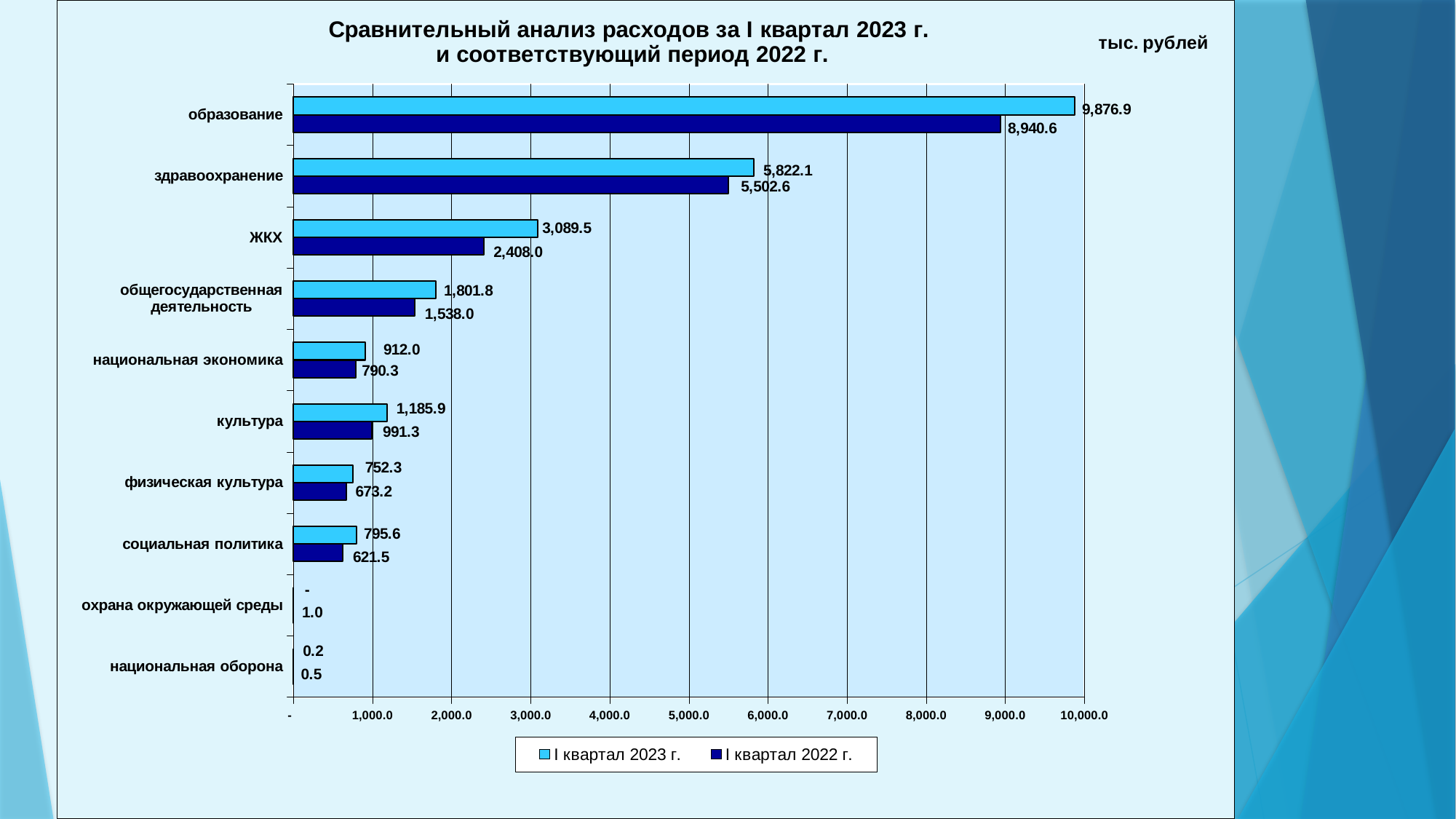
What is the value for здравоохранение in I квартал 2022 г.? 5,502.6 Which category has the lowest value in I квартал 2022 г.? национальная оборона What is the value for ЖКХ in I квартал 2022 г.? 2,408.0 Which category has the highest value in I квартал 2023 г.? образование What unit is indicated in the top right corner of the chart? тыс. рублей How many categories are shown on the chart? 10 What is the value for социальная политика in I квартал 2023 г.? 795.6 What is the difference between the I квартал 2023 г. and I квартал 2022 г. values for образование? 936.3 How many series does the legend list? 2 What is the value for образование in I квартал 2023 г.? 9,876.9 What type of chart is shown on the slide? bar chart Which is larger for культура: the I квартал 2023 г. value or the I квартал 2022 г. value? I квартал 2023 г.